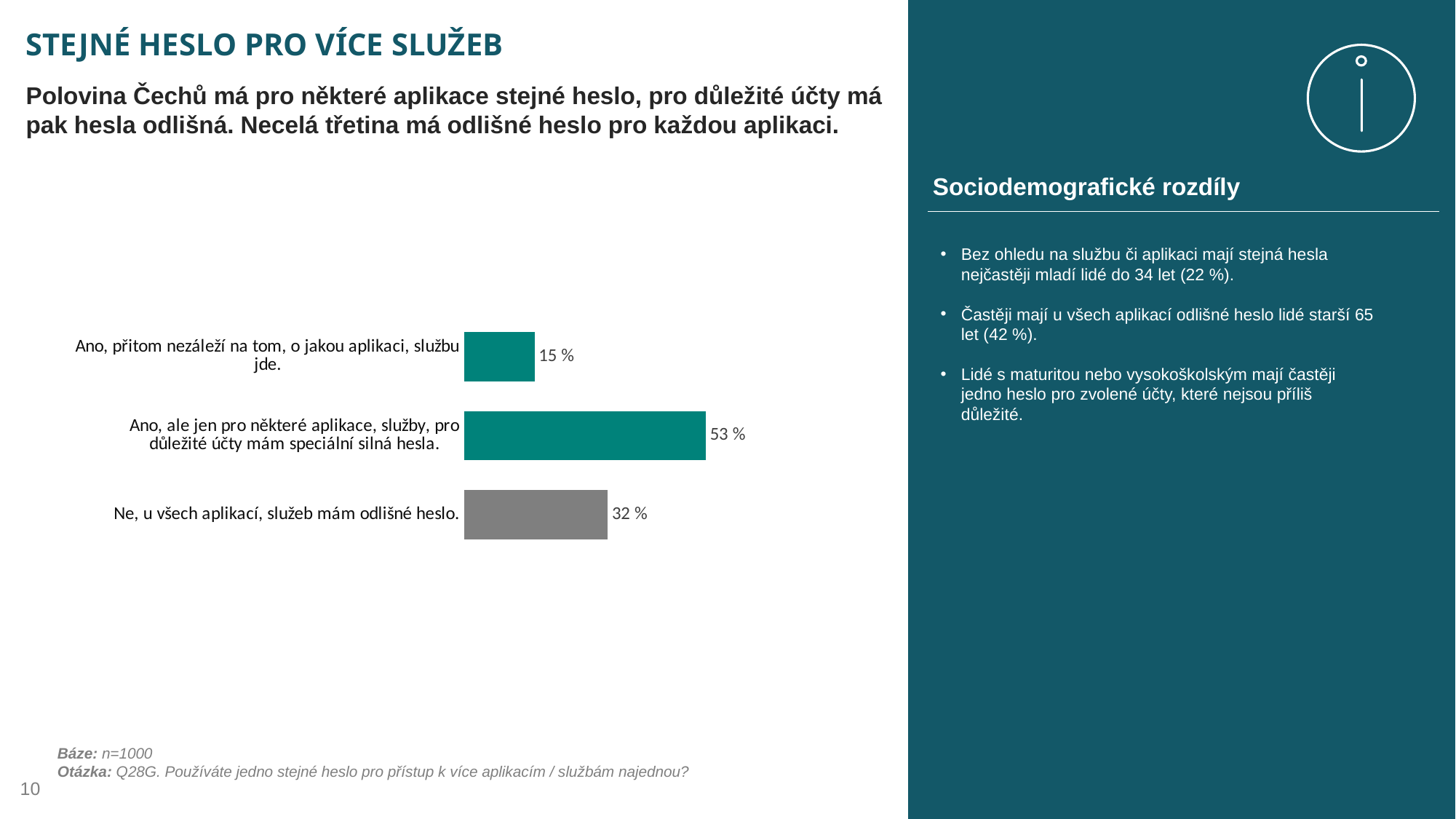
What is the difference between the values for "Ano, ale jen pro některé aplikace..." and "Ne, u všech aplikací, služeb mám odlišné heslo."? 21 % Which is larger: the value for "Ne, u všech aplikací, služeb mám odlišné heslo." or for "Ano, přitom nezáleží na tom, o jakou aplikaci, službu jde."? Ne, u všech aplikací, služeb mám odlišné heslo. What is the value for "Ano, přitom nezáleží na tom, o jakou aplikaci, službu jde."? 15 % What is the difference between the values for "Ne, u všech aplikací, služeb mám odlišné heslo." and "Ano, přitom nezáleží na tom, o jakou aplikaci, službu jde."? 17 % How many categories does the chart show? 3 What is the total of the three values shown in the chart? 100 % What is the value for "Ne, u všech aplikací, služeb mám odlišné heslo."? 32 % What kind of chart is shown on the slide? Bar chart Which category has the lowest value? Ano, přitom nezáleží na tom, o jakou aplikaci, službu jde. Which category has the highest value? Ano, ale jen pro některé aplikace, služby, pro důležité účty mám speciální silná hesla. What is the value for "Ano, ale jen pro některé aplikace, služby, pro důležité účty mám speciální silná hesla."? 53 % What colour is the bar for "Ne, u všech aplikací, služeb mám odlišné heslo."? Grey